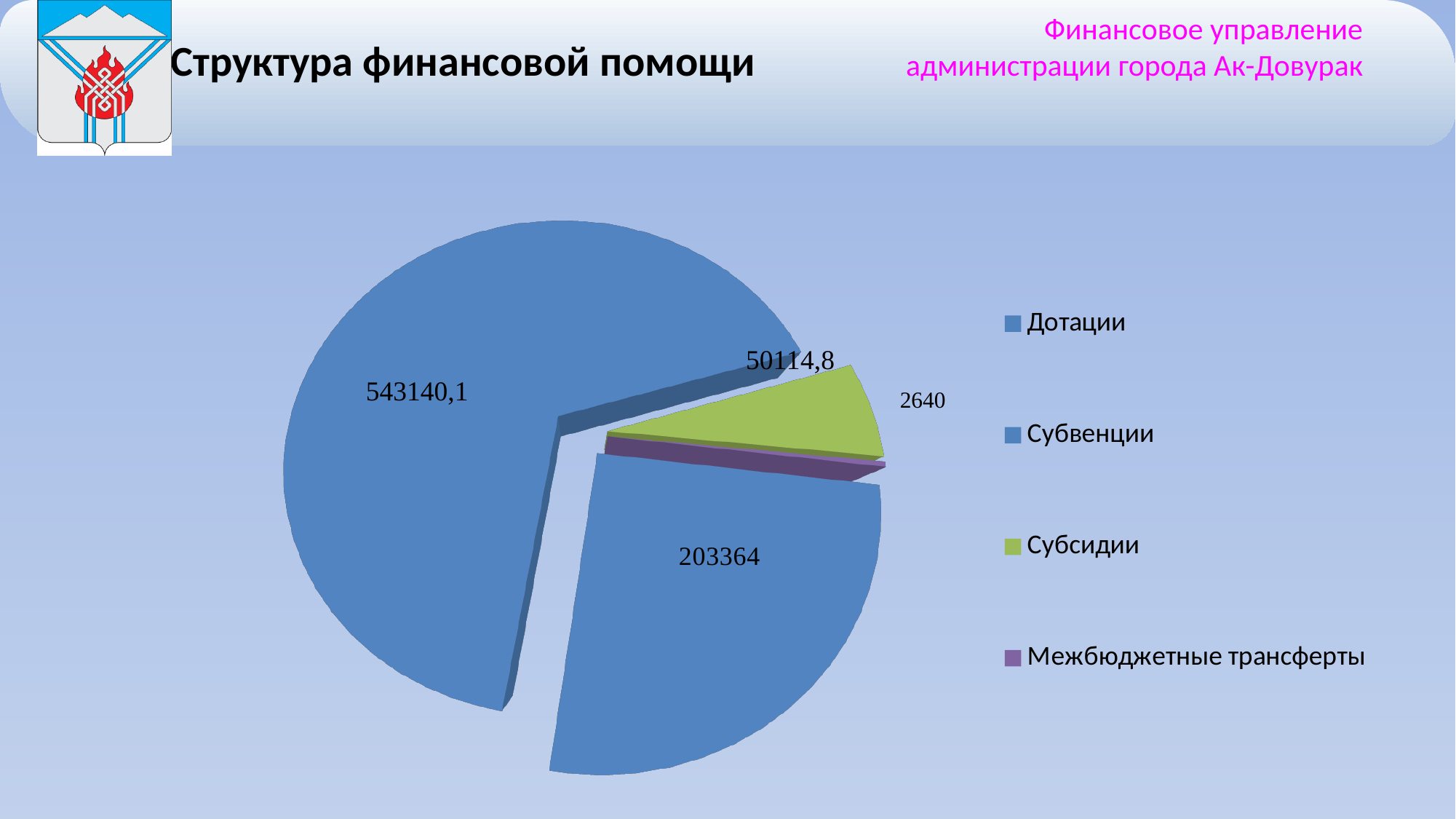
What is the value for Межбюджетные трансферты? 2640 Which category has the smallest slice of the pie? Межбюджетные трансферты What is the value for Дотации? 203364 What is the value for Субсидии? 50114,8 Which category has the largest slice of the pie? Субвенции What is the difference between the values for Дотации and Субвенции? 339776,1 How many categories does the legend list? 4 What is the difference between the values for Субсидии and Межбюджетные трансферты? 47474,8 What is the title of the chart? Структура финансовой помощи What type of chart is shown on the slide? Pie chart What is the value for Субвенции? 543140,1 Which is larger, the value for Субвенции or the value for Субсидии? Субвенции